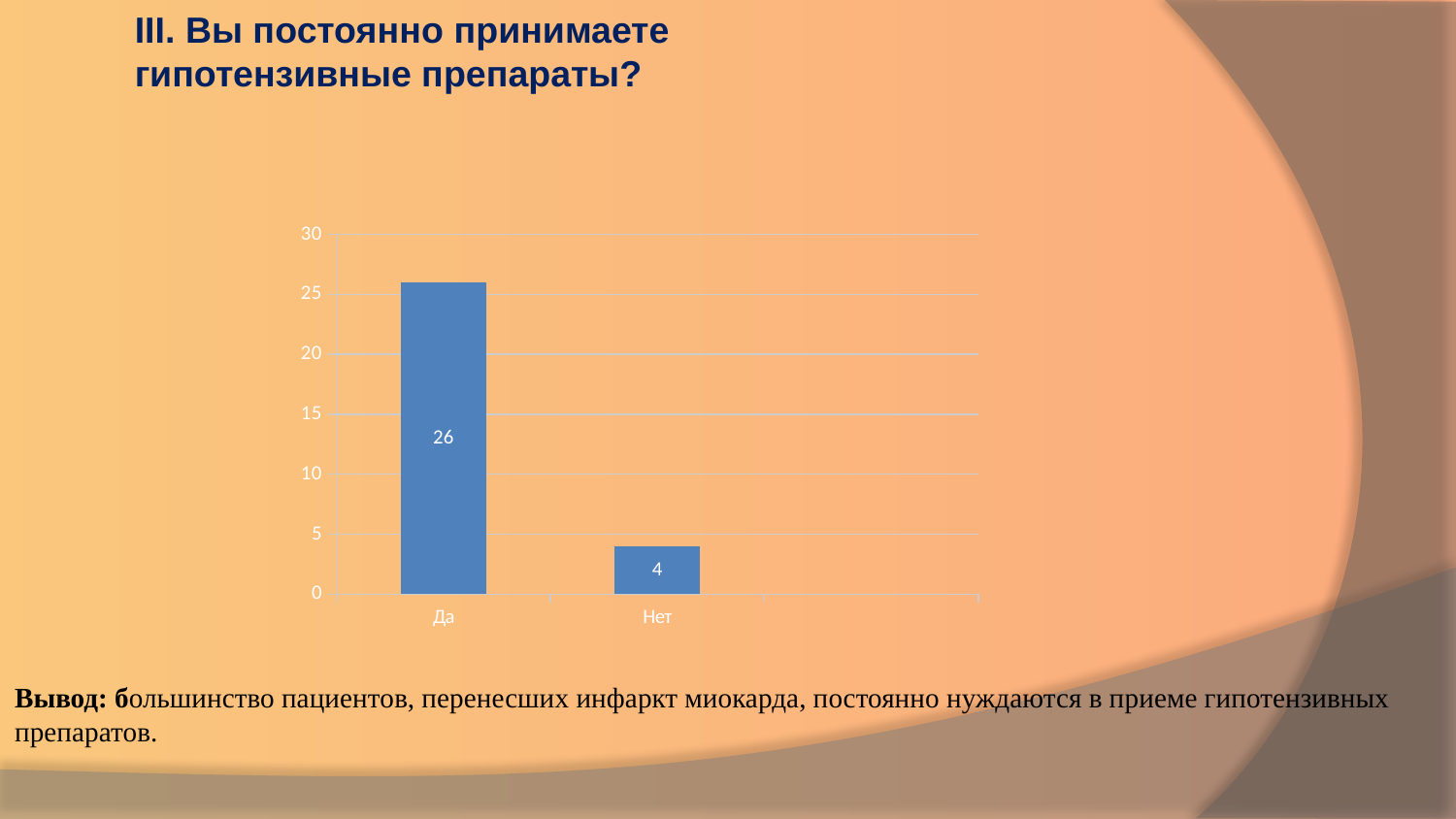
Which category has the lowest value? Нет What is the total of the two bars? 30 What is the value for "Да"? 26 What is the value for "Нет"? 4 Which category has the highest value? Да What is the difference between the values for "Да" and "Нет"? 22 What kind of chart is shown on the slide? bar chart What is the maximum value shown on the vertical axis? 30 Is the value for "Да" greater or less than 20? greater Is the value for "Нет" greater or less than 5? less How many categories are shown on the x axis? 2 Which is larger, the value for "Да" or the value for "Нет"? Да